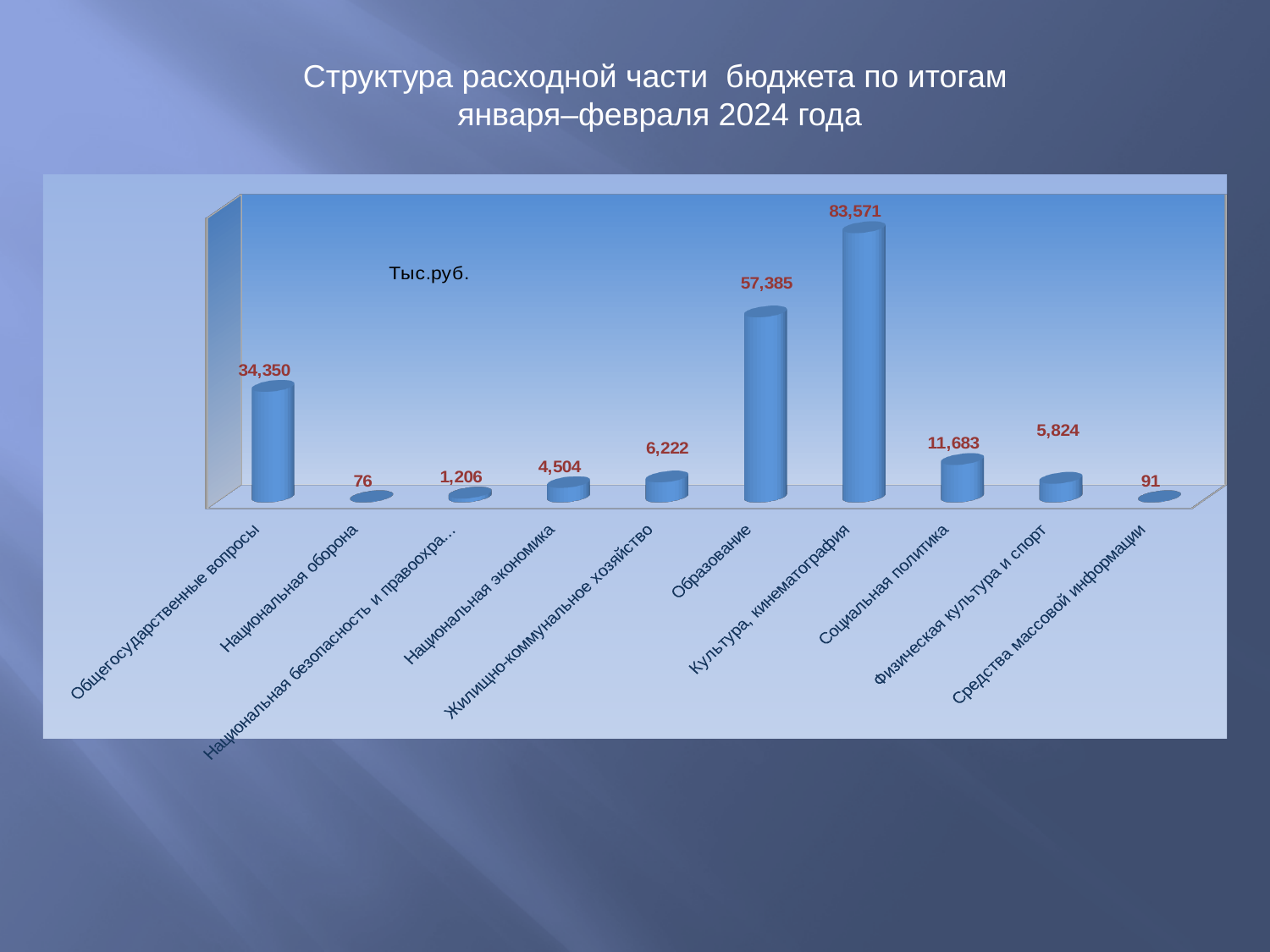
What unit is indicated on the chart? Тыс.руб. What kind of chart is shown on the slide? Bar chart What is the value for Образование? 57,385 What is the difference between the values for Культура, кинематография and Образование? 26,186 What is the value for Социальная политика? 11,683 Which category has the lowest value? Национальная оборона What is the value for Средства массовой информации? 91 What is the difference between the values for Социальная политика and Физическая культура и спорт? 5,859 Which is larger, the value for Жилищно-коммунальное хозяйство or the value for Национальная экономика? Жилищно-коммунальное хозяйство What is the value for Национальная оборона? 76 Which category has the highest value? Культура, кинематография How many categories are shown in the chart? 10